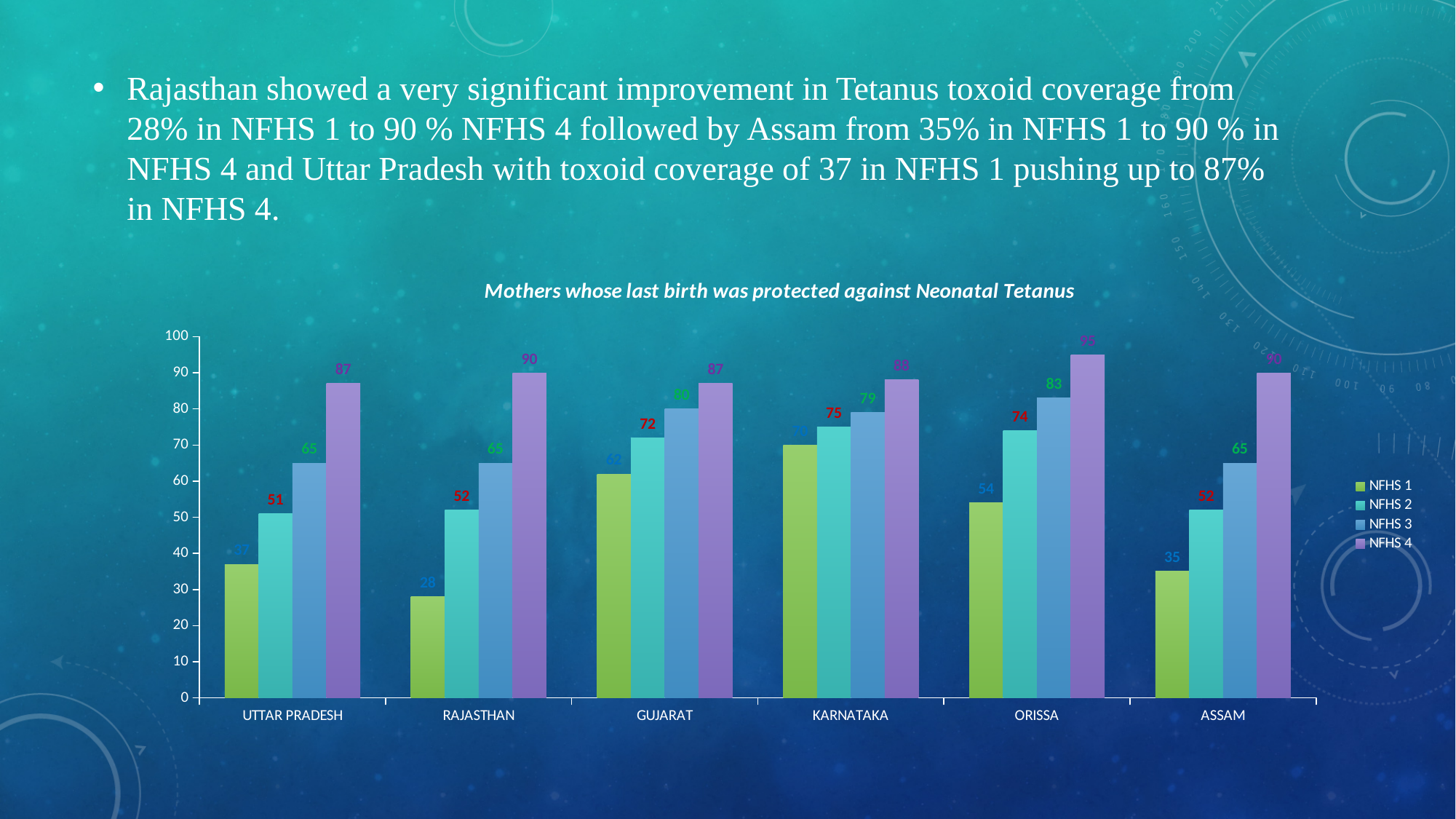
What is the NFHS 4 value for Uttar Pradesh? 87 What is the difference between the NFHS 4 and NFHS 1 values for Rajasthan? 62 Which state has the lowest NFHS 1 value? Rajasthan How many series does the legend list? 4 What is the NFHS 2 value for Gujarat? 72 What kind of chart is shown on the slide? Bar chart Is the NFHS 1 value for Karnataka greater or less than 60? greater How many states are shown on the x axis? 6 Which is larger, the NFHS 2 value for Orissa or the NFHS 2 value for Assam? Orissa What is the NFHS 3 value for Orissa? 83 Which state has the highest NFHS 4 value? Orissa What is the NFHS 1 value for Rajasthan? 28